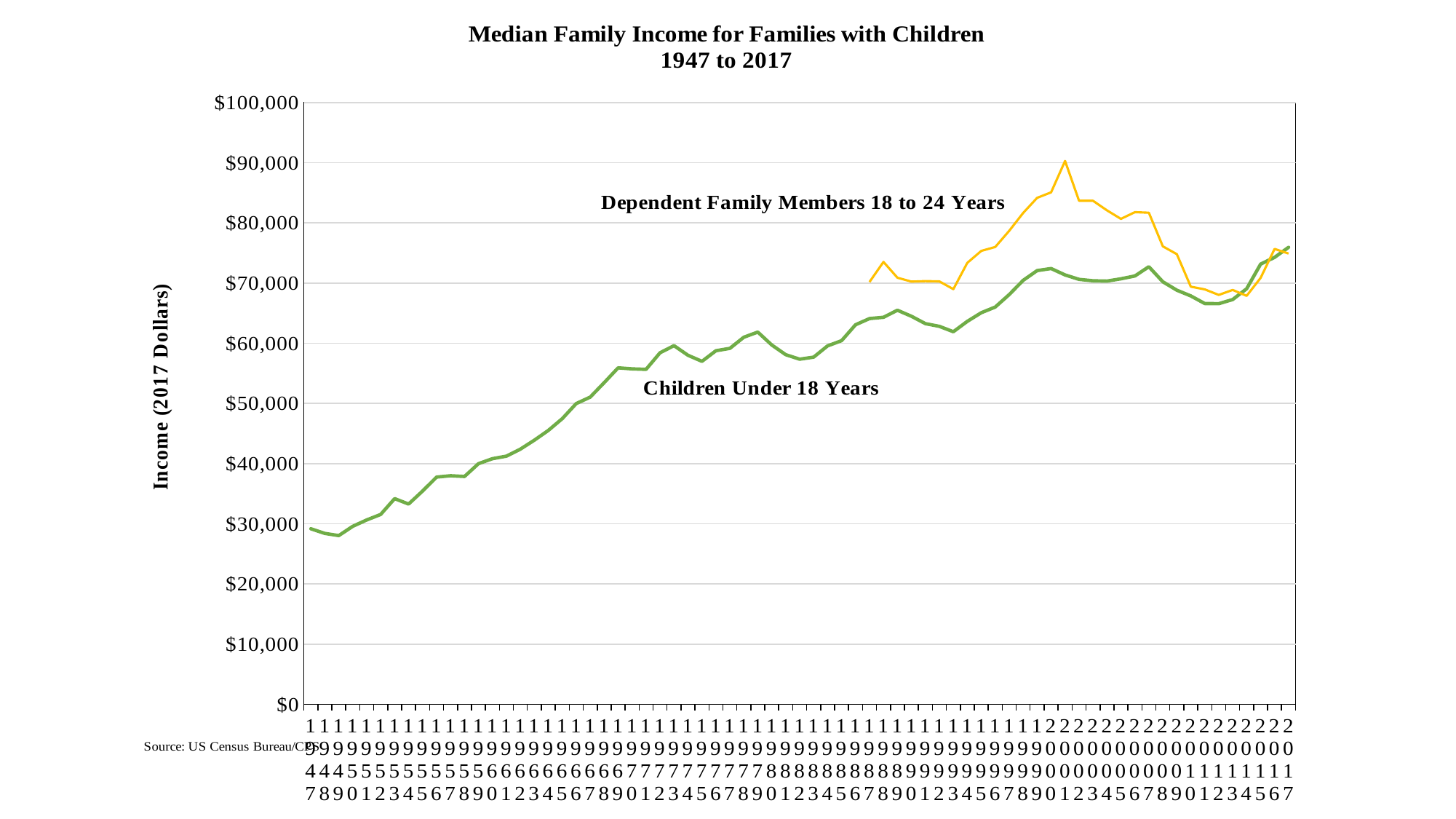
What is the title of the chart? Median Family Income for Families with Children 1947 to 2017 What is the label on the vertical axis of the chart? Income (2017 Dollars) Is the value for Children Under 18 Years in 1970 greater or less than $50,000? greater How many data series are plotted on the chart? 2 For Children Under 18 Years, which year has the larger value: 1947 or 2017? 2017 Which series reaches the highest value anywhere on the chart? Dependent Family Members 18 to 24 Years What kind of chart is shown on the slide? line chart Around the year 2000, which series has the higher value: Children Under 18 Years or Dependent Family Members 18 to 24 Years? Dependent Family Members 18 to 24 Years Does the Children Under 18 Years line rise or fall overall from 1947 to 2017? rise Is the value for Children Under 18 Years in 2017 greater or less than $70,000? greater Is the value for Children Under 18 Years in 1947 greater or less than $40,000? less